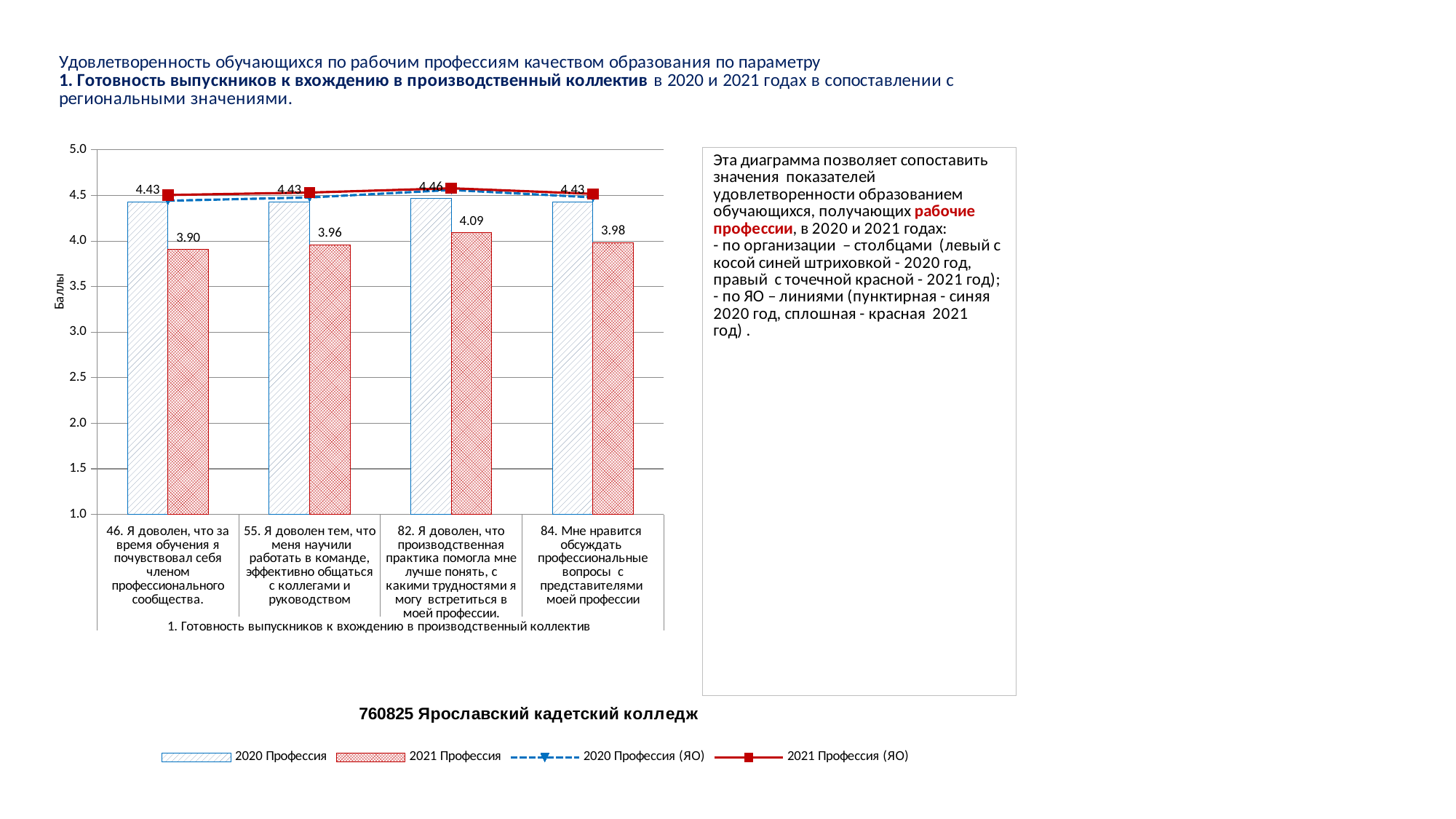
What is the title of the vertical axis of the chart? Баллы Which category has the highest 2021 Профессия value? 82. Я доволен, что производственная практика помогла мне лучше понять, с какими трудностями я могу встретиться в моей профессии. Which is larger: the 2021 Профессия value for category 55 or for category 84? Category 84 (3.98) What is the difference between the 2021 Профессия values for category 82 and category 46? 0.19 How many categories are shown on the x axis of the chart? 4 What is the value of the 2021 Профессия bar for category 82 (Я доволен, что производственная практика помогла мне лучше понять...)? 4.09 How many series does the chart legend list? 4 What is the value of the 2020 Профессия bar for category 46 (Я доволен, что за время обучения я почувствовал себя членом профессионального сообщества)? 4.43 What is the difference between the 2020 Профессия and 2021 Профессия values for category 82? 0.37 Is the value of the 2020 Профессия (ЯО) line for category 46 greater or less than 4.0? greater Which category has the lowest 2021 Профессия value? 46. Я доволен, что за время обучения я почувствовал себя членом профессионального сообщества. What is the value of the 2021 Профессия bar for category 84 (Мне нравится обсуждать профессиональные вопросы...)? 3.98